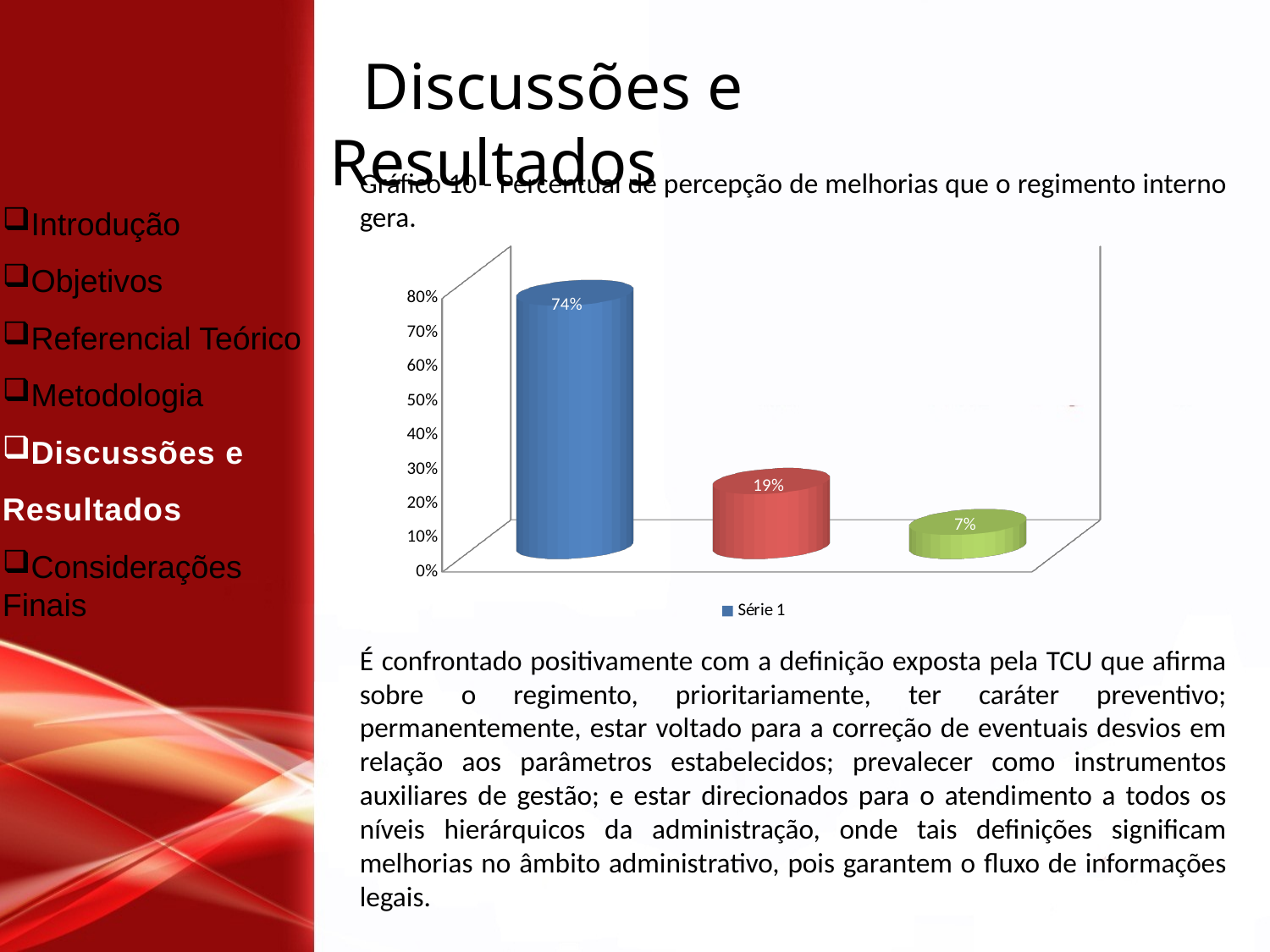
Which bar is larger, the red (second) bar or the green (third) bar? the red (second) bar What is the highest value plotted in the chart? 74% How many bars are plotted in the chart? 3 Do the values rise or fall from left to right across the bars? fall What type of chart is shown on the slide? bar chart What is the lowest value plotted in the chart? 7% What is the value shown on the green (third) bar? 7% What is the value shown on the blue (first) bar? 74% What is the difference between the first bar (74%) and the second bar (19%)? 55% What is the name of the series shown in the legend? Série 1 What is the value shown on the red (second) bar? 19% How many series does the legend list? 1